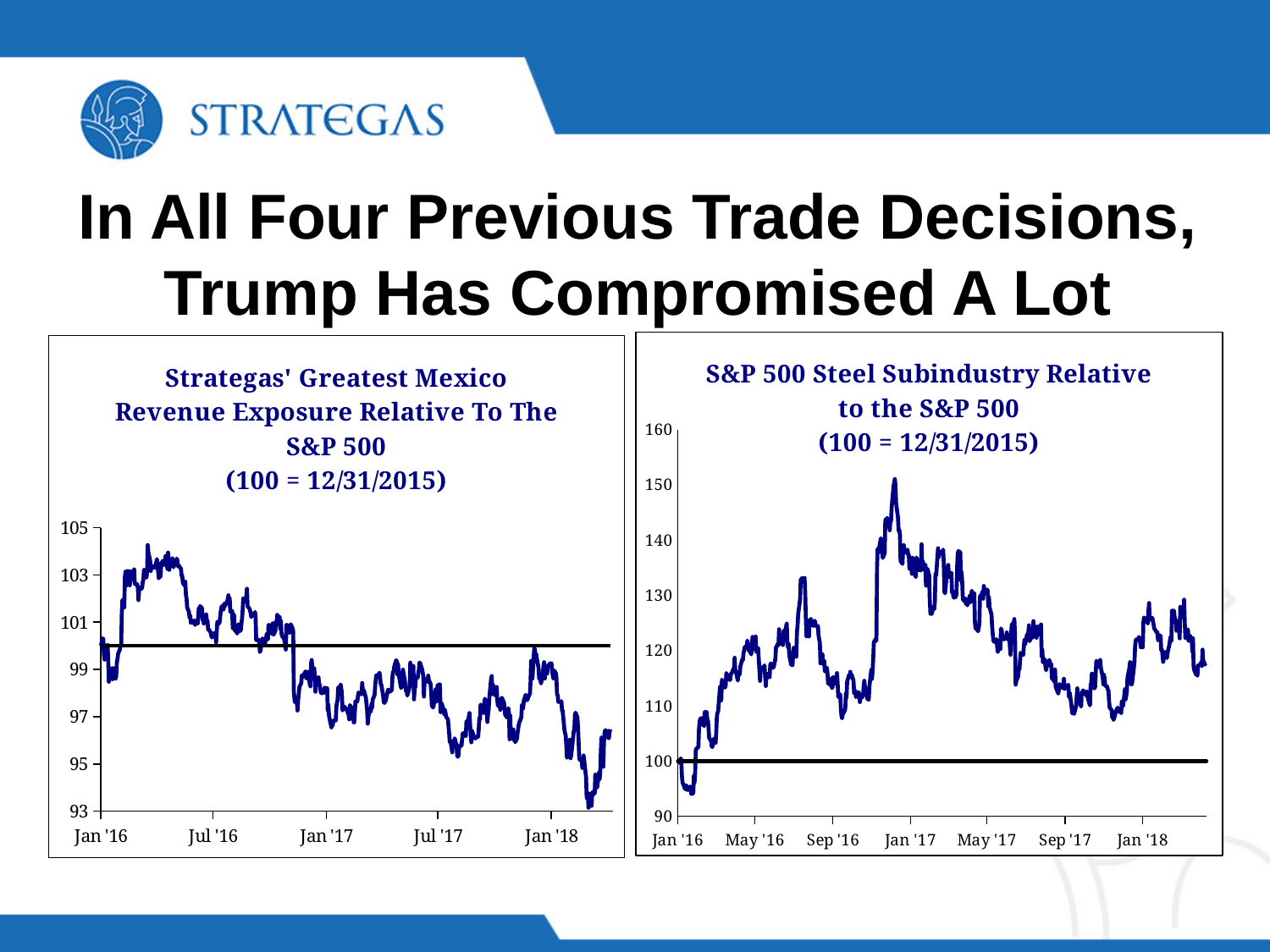
What value does the horizontal black reference line mark in both charts? 100 What kind of chart is the right chart, 'S&P 500 Steel Subindustry Relative to the S&P 500'? line chart In the right chart (S&P 500 Steel Subindustry), which is larger, the value at Jan '17 or the value at Jan '18? Jan '17 In the left chart (Mexico Revenue Exposure), is the highest point of the line greater or less than 103? greater In the right chart (S&P 500 Steel Subindustry), is the peak of the line greater or less than 140? greater In the right chart (S&P 500 Steel Subindustry), is the value at Sep '17 greater or less than 120? less In the left chart (Mexico Revenue Exposure), does the line overall rise or fall from Jan '16 to the end of the series? fall In the right chart (S&P 500 Steel Subindustry), does the line overall rise or fall from Jan '16 to the end of the series? rise What kind of chart is the left chart, 'Strategas' Greatest Mexico Revenue Exposure Relative To The S&P 500'? line chart